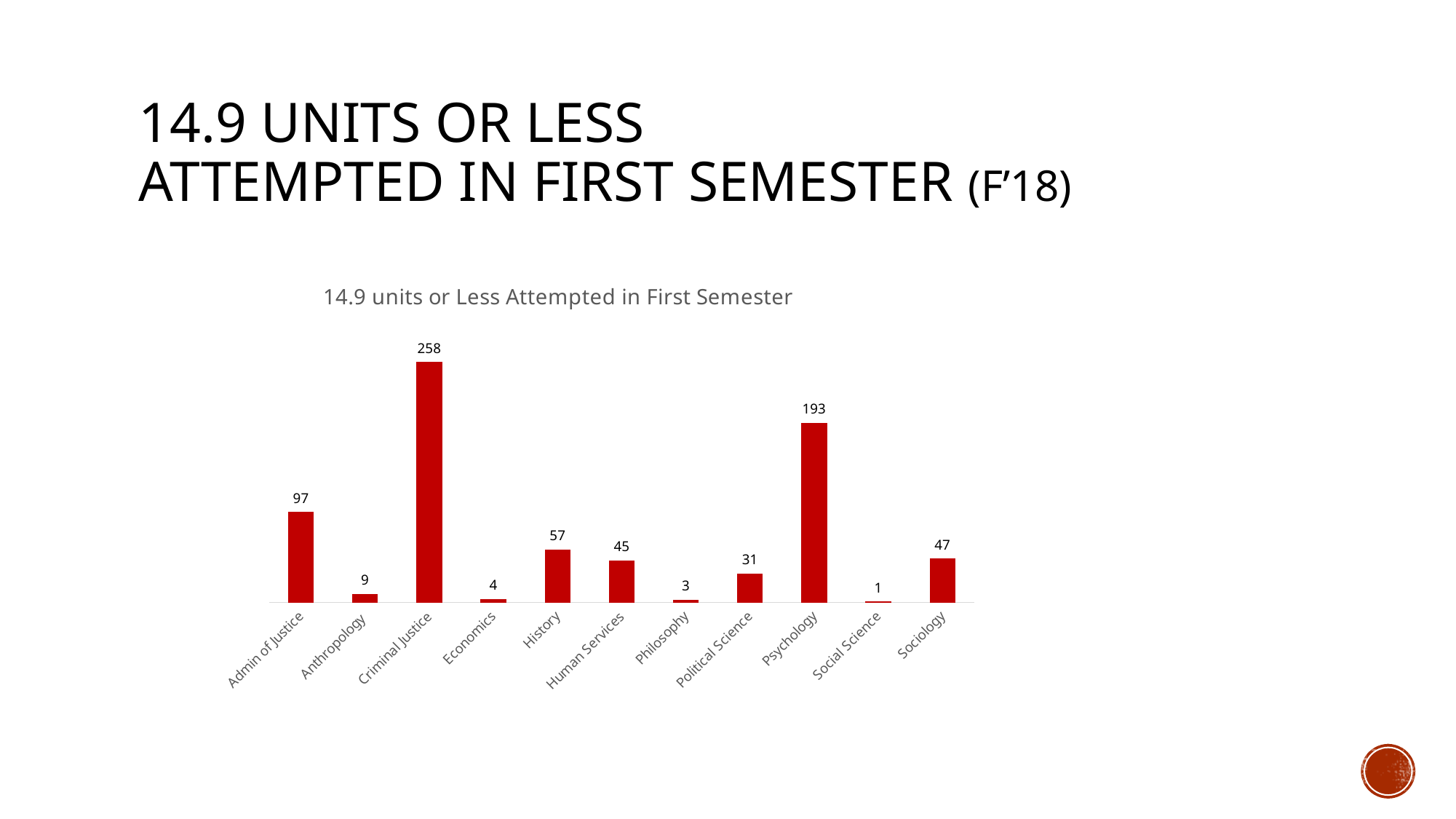
Which category has the highest value? Criminal Justice What is the value for Psychology? 193 Which category has the lowest value? Social Science What is the difference between the values for Admin of Justice and Sociology? 50 What is the difference between the values for Criminal Justice and Psychology? 65 What is the value for Criminal Justice? 258 What is the value for Social Science? 1 What is the value for Human Services? 45 What kind of chart is shown on the slide? Bar chart How many categories are shown on the x axis? 11 Which is larger, the value for History or the value for Political Science? History What is the title of the chart? 14.9 units or Less Attempted in First Semester